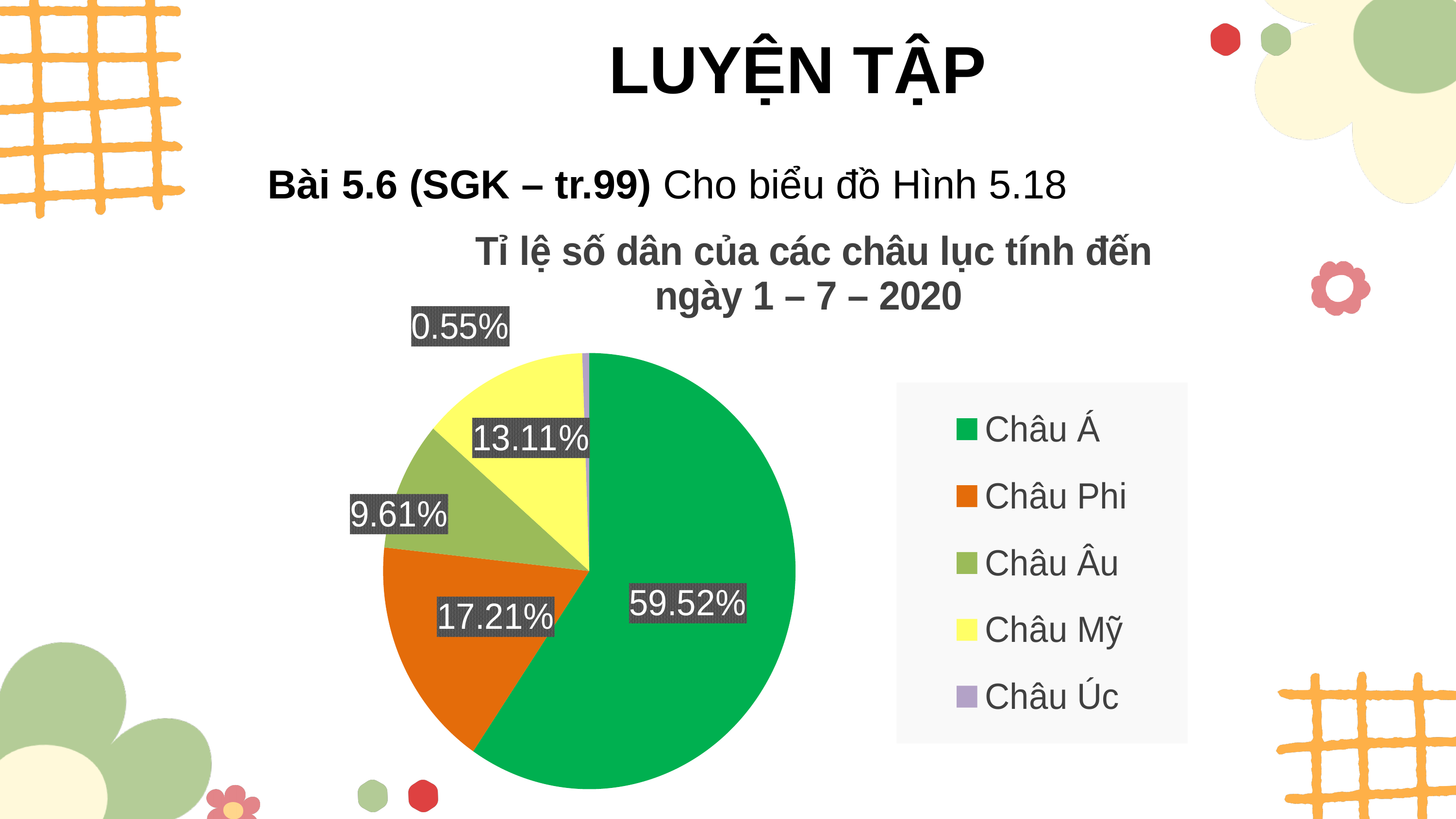
What is the difference between the shares of Châu Phi and Châu Âu? 7.60% What percentage of the population does Châu Á account for in the pie chart? 59.52% What is the value shown for Châu Phi in the pie chart? 17.21% What percentage is shown for Châu Mỹ? 13.11% Which continent has the largest share in the pie chart? Châu Á How many continents are shown in the pie chart? 5 What is the title of the chart? Tỉ lệ số dân của các châu lục tính đến ngày 1 – 7 – 2020 What is the value for Châu Úc in the pie chart? 0.55% Which continent is represented by the yellow slice? Châu Mỹ Which has a larger share, Châu Mỹ or Châu Âu? Châu Mỹ Which continent has the smallest share in the pie chart? Châu Úc What type of chart is shown on the slide? Pie chart